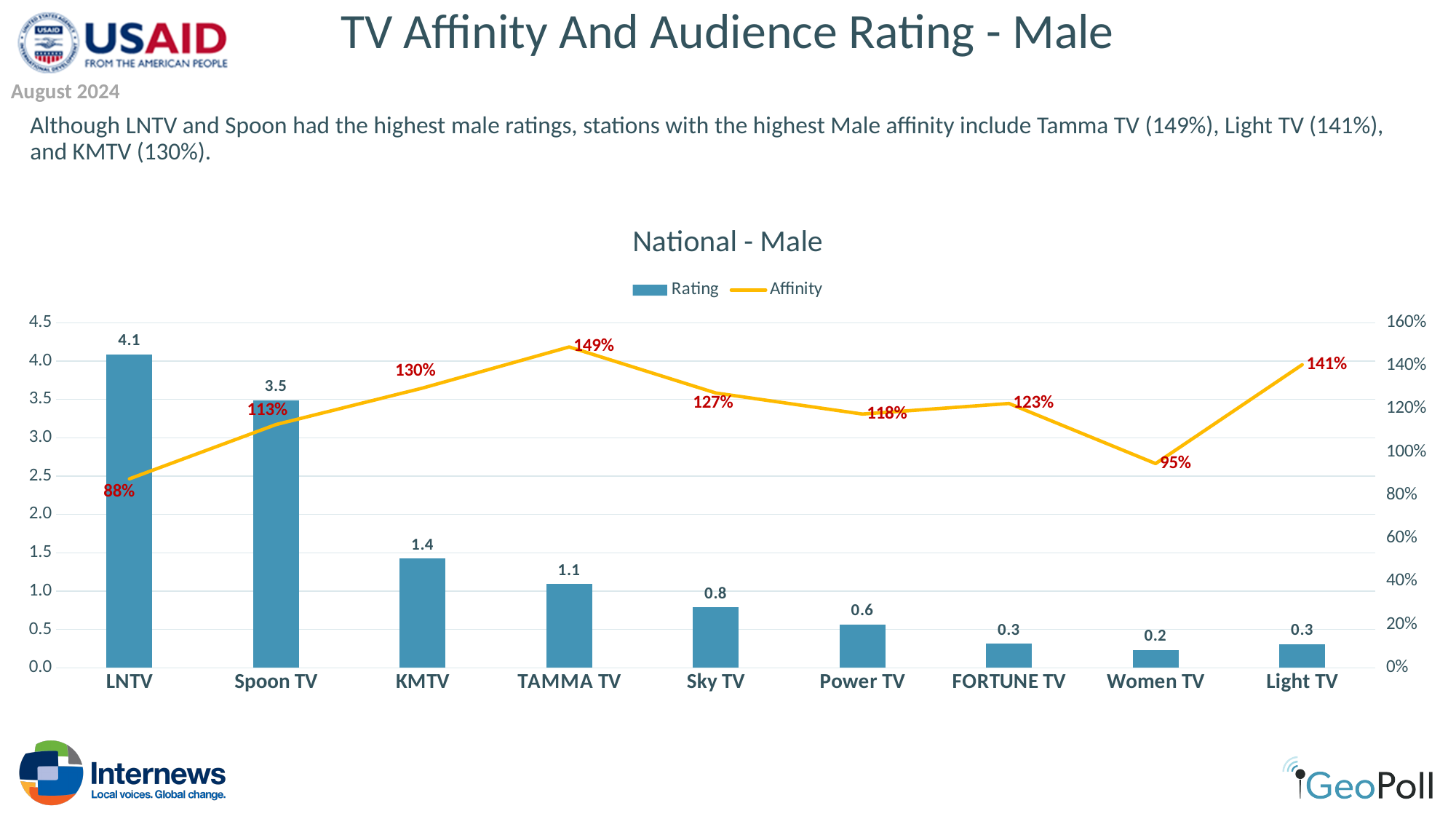
Which station has the highest Affinity? TAMMA TV What is the Rating value for LNTV? 4.1 Which station has the highest Rating? LNTV What is the Affinity value for TAMMA TV? 149% What is the title of the chart? National - Male How many series does the legend list? 2 What is the Rating value for Power TV? 0.6 Which station has the lowest Affinity? LNTV How many stations are shown on the x axis? 9 What is the difference between the Rating for LNTV and the Rating for Spoon TV? 0.6 Which is larger, the Affinity for KMTV or the Affinity for Sky TV? KMTV What is the Affinity value for Women TV? 95%